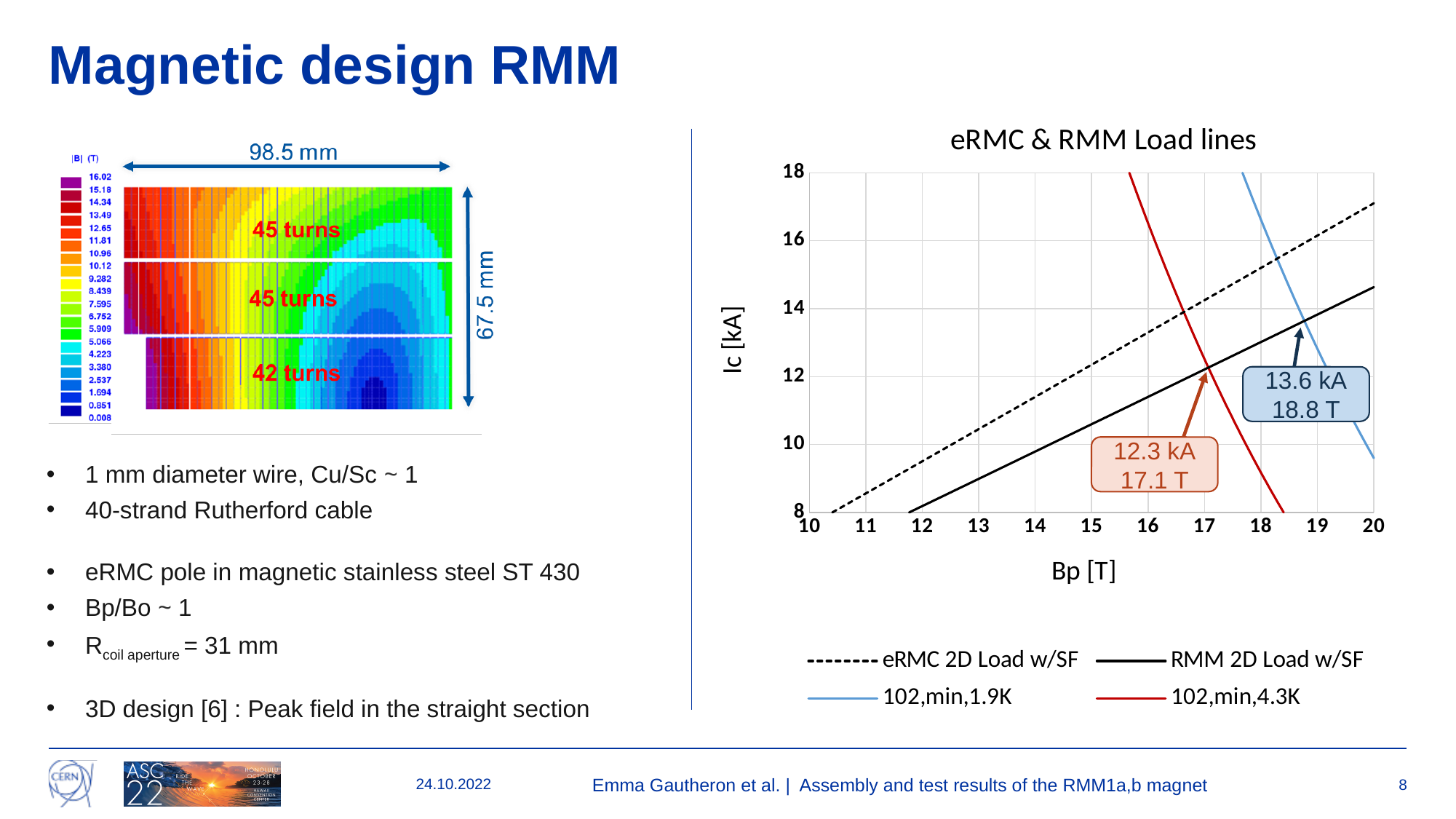
What is the difference in current between the two annotated intersection points (13.6 kA and 12.3 kA)? 1.3 kA What current is annotated at the intersection of the RMM 2D load line with the 102,min,1.9K curve? 13.6 kA Which annotated intersection has the higher current, the one with the 1.9K curve or the one with the 4.3K curve? 1.9K Does the RMM 2D Load w/SF line rise or fall as Bp increases? rise What peak field is annotated at the intersection of the RMM 2D load line with the 102,min,4.3K curve? 17.1 T What current is annotated at the intersection of the RMM 2D load line with the 102,min,4.3K curve? 12.3 kA How many series does the chart legend list? 4 What is the difference in peak field between the two annotated intersection points (18.8 T and 17.1 T)? 1.7 T What peak field is annotated at the intersection of the RMM 2D load line with the 102,min,1.9K curve? 18.8 T What type of chart is shown on the slide? line chart At Bp = 15 T, is the value of the RMM 2D Load w/SF line greater or less than 12 kA? less What is the title of the chart? eRMC & RMM Load lines